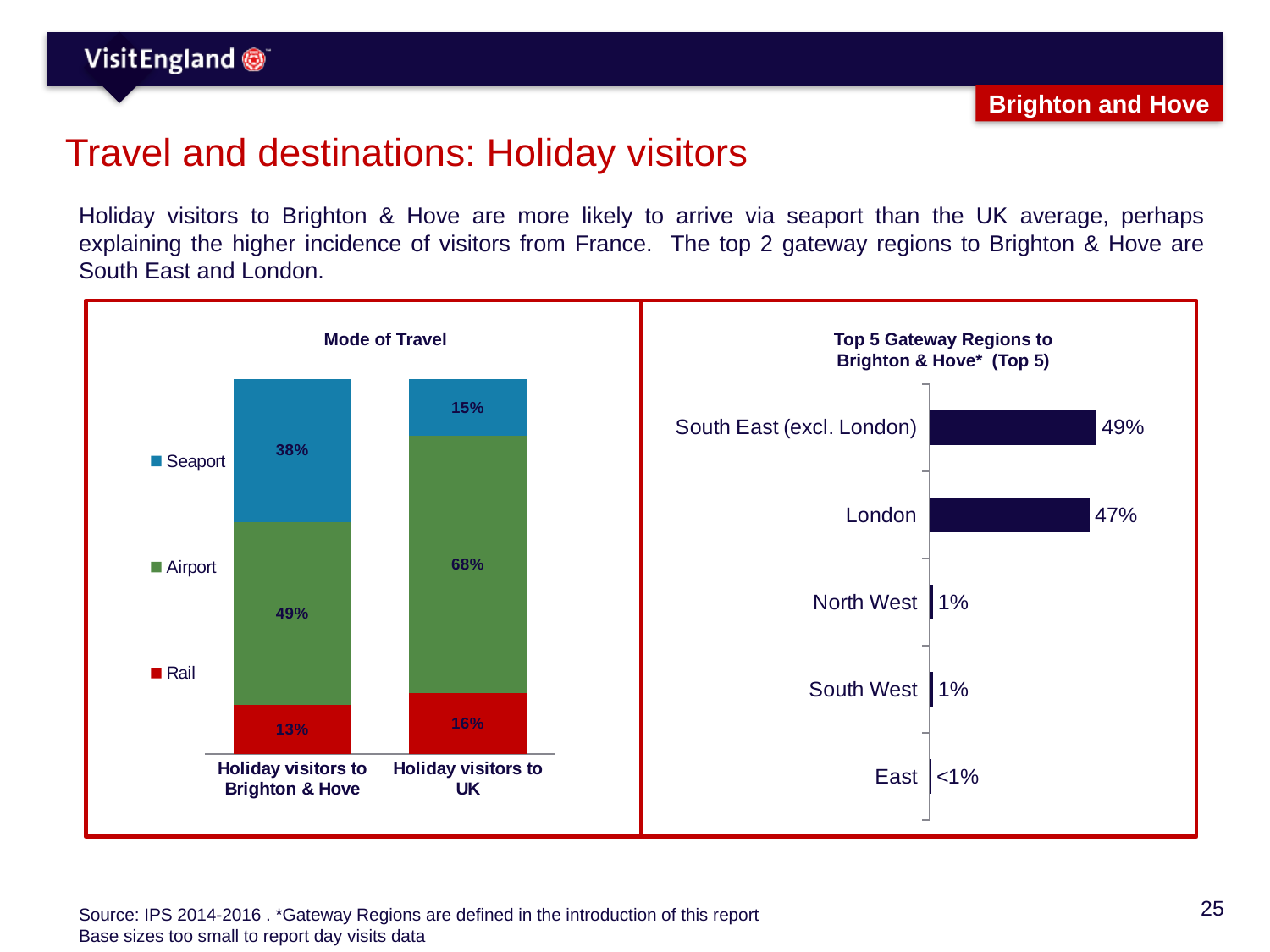
In the Top 5 Gateway Regions chart, which region has the highest value? South East (excl. London) In the Mode of Travel chart, how many series does the legend list? 3 In the Top 5 Gateway Regions chart, what is the value for East? <1% In the Top 5 Gateway Regions chart, how many regions are shown? 5 In the Mode of Travel chart, which is larger: the airport share for holiday visitors to Brighton & Hove or for holiday visitors to the UK? Holiday visitors to UK In the Top 5 Gateway Regions chart, what is the value for London? 47% In the Mode of Travel chart, what percentage of holiday visitors to the UK arrive by airport? 68% What kind of chart is the Top 5 Gateway Regions chart? Bar chart In the Mode of Travel chart, what is the rail share for holiday visitors to Brighton & Hove? 13% In the Mode of Travel chart, what is the difference between the seaport share for holiday visitors to Brighton & Hove and for holiday visitors to the UK? 23 percentage points In the Mode of Travel chart, what is the total of the stacked bar for holiday visitors to Brighton & Hove? 100% In the Mode of Travel chart, what percentage of holiday visitors to Brighton & Hove arrive by seaport? 38%